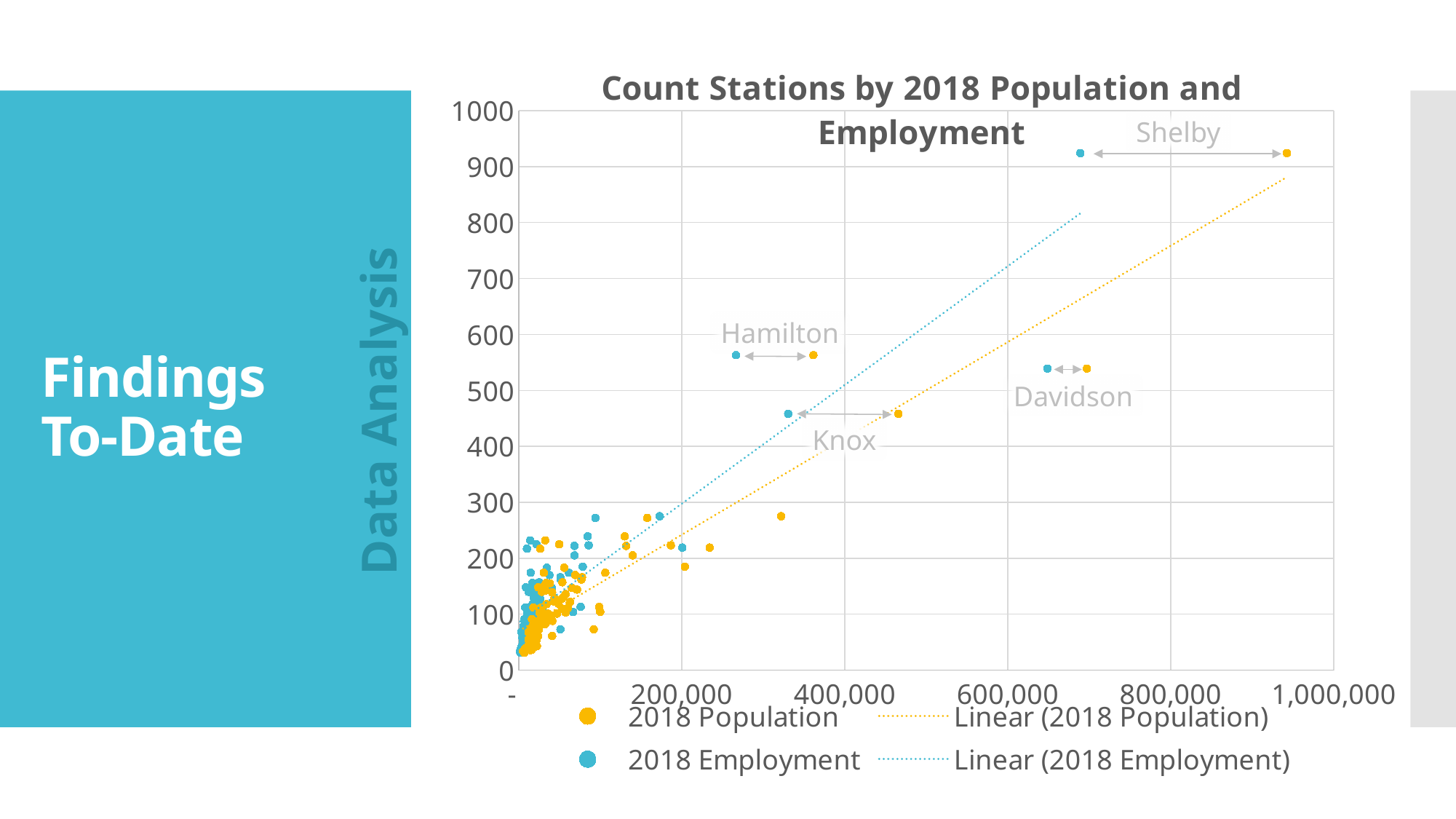
What kind of chart is shown on the slide? Scatter chart Which labelled county has the lowest number of count stations? Knox Which has more count stations, Hamilton or Knox? Hamilton Which colour represents the 2018 Employment series? Blue Is the number of count stations for Shelby greater or less than 900? greater What is the title of the chart? Count Stations by 2018 Population and Employment Which labelled county has the highest number of count stations? Shelby Do the number of count stations generally rise or fall as population and employment increase along the x axis? Rise Is the 2018 Employment value for Hamilton greater or less than 400,000? less How many entries does the chart's legend list? 4 Is the 2018 Population value for Shelby greater or less than 800,000? greater